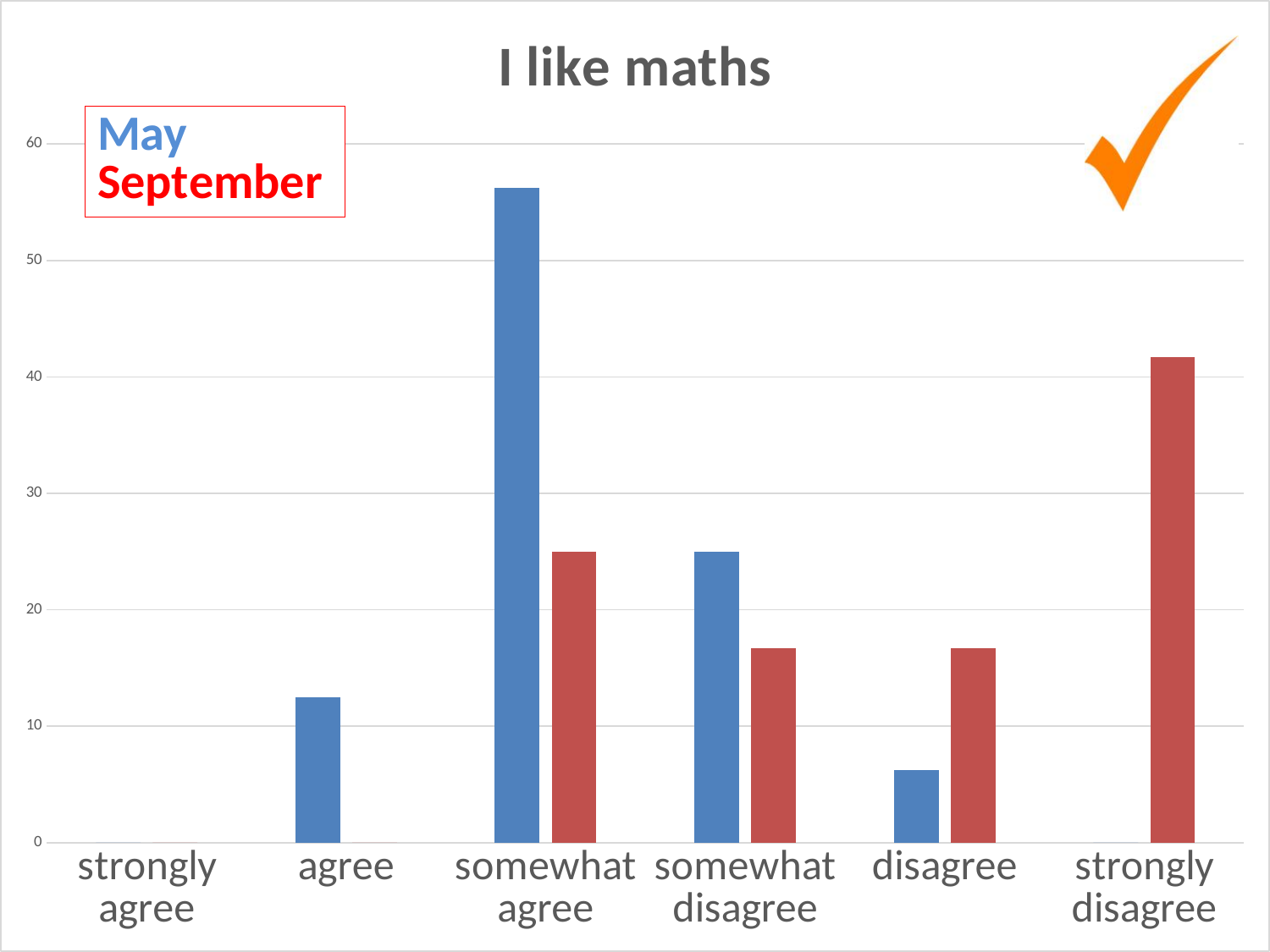
What kind of chart is shown on the slide? bar chart What is the title of the chart? I like maths Which category has the highest value for May? somewhat agree For somewhat agree, which series has the larger value, May or September? May Is the May value for somewhat agree greater or less than 50? greater Is the May value for disagree greater or less than 10? less For disagree, which series has the larger value, May or September? September Is the September value for somewhat disagree greater or less than 20? less How many categories are shown on the x axis? 6 How many series does the legend list? 2 Which category has the highest value for September? strongly disagree